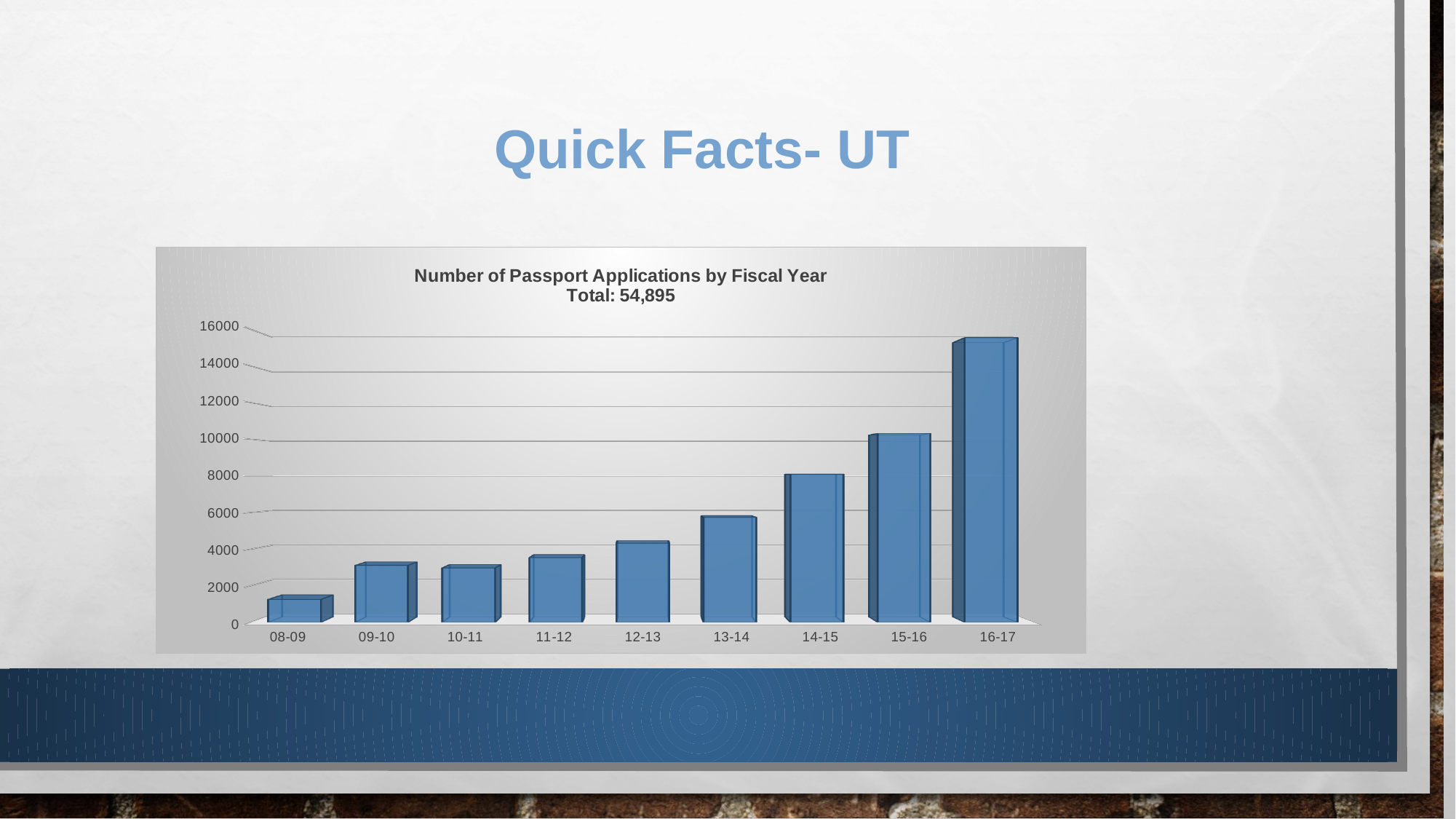
What is the title of the chart? Number of Passport Applications by Fiscal Year Total: 54,895 Is the value for 16-17 greater or less than 14000? greater Is the value for 12-13 greater or less than 6000? less How many fiscal years are shown on the x axis of the chart? 9 Which fiscal year has the highest number of passport applications? 16-17 What kind of chart is shown on the slide? Bar chart What total number of passport applications is stated in the chart title? 54,895 Do the number of passport applications generally rise or fall from 08-09 to 16-17? Rise Which has more passport applications, 13-14 or 12-13? 13-14 Is the value for 15-16 greater or less than 8000? greater Which fiscal year has the lowest number of passport applications? 08-09